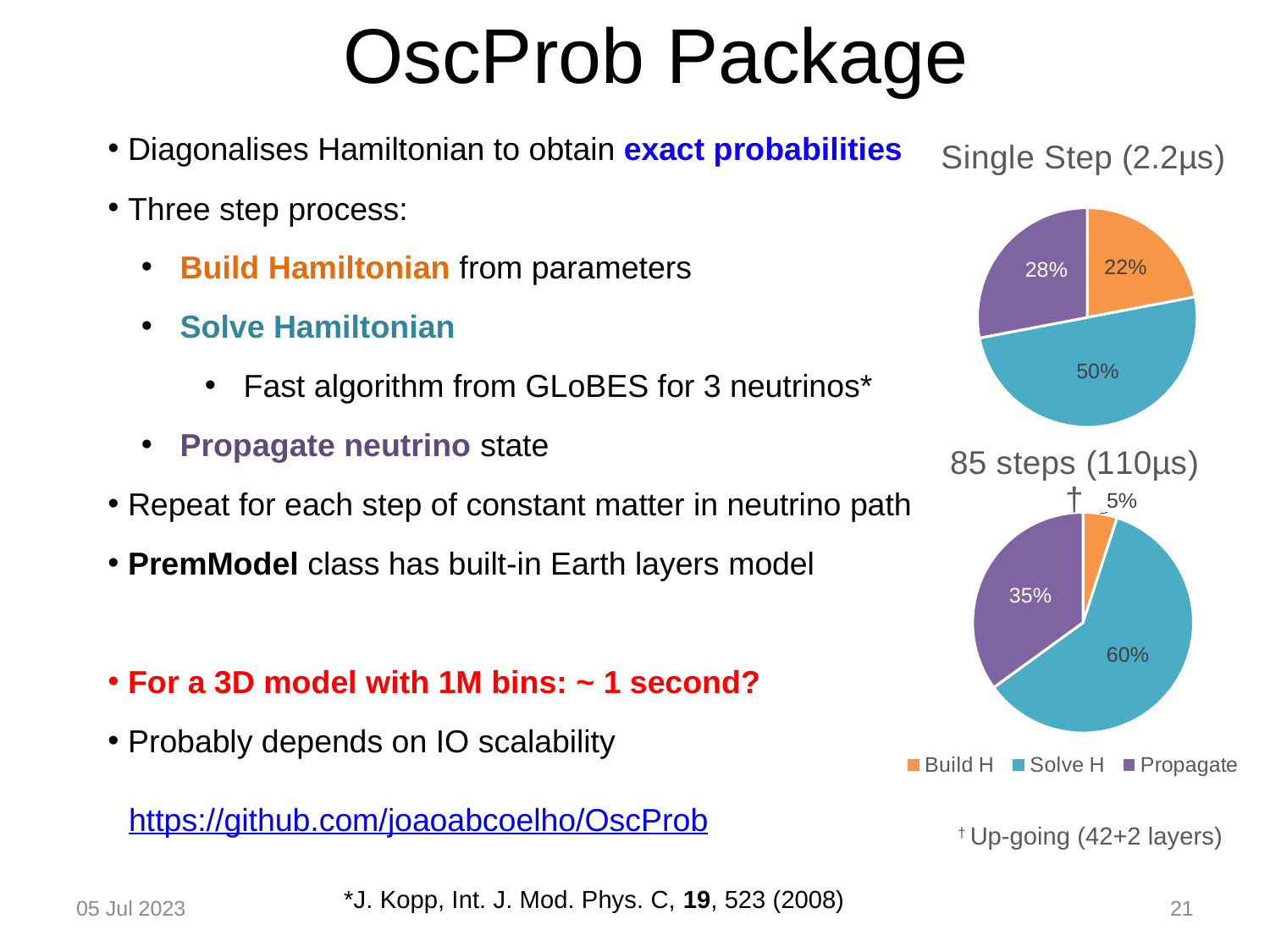
In the '85 steps (110μs)' pie chart, which is larger, Propagate or Build H? Propagate In the 'Single Step (2.2μs)' pie chart, what share does Propagate have? 28% In the '85 steps (110μs)' pie chart, what share does Build H have? 5% How many series does the legend list for the pie charts? 3 In the 'Single Step (2.2μs)' pie chart, what is the difference between the Solve H and Propagate shares? 22% In the '85 steps (110μs)' pie chart, what share does Propagate have? 35% In the 'Single Step (2.2μs)' pie chart, which category has the largest slice? Solve H In the '85 steps (110μs)' pie chart, what share does Solve H have? 60% In the '85 steps (110μs)' pie chart, which category has the smallest slice? Build H What type of chart is used for 'Single Step (2.2μs)'? Pie chart In the 'Single Step (2.2μs)' pie chart, what share does Build H have? 22% In the 'Single Step (2.2μs)' pie chart, what share does Solve H have? 50%